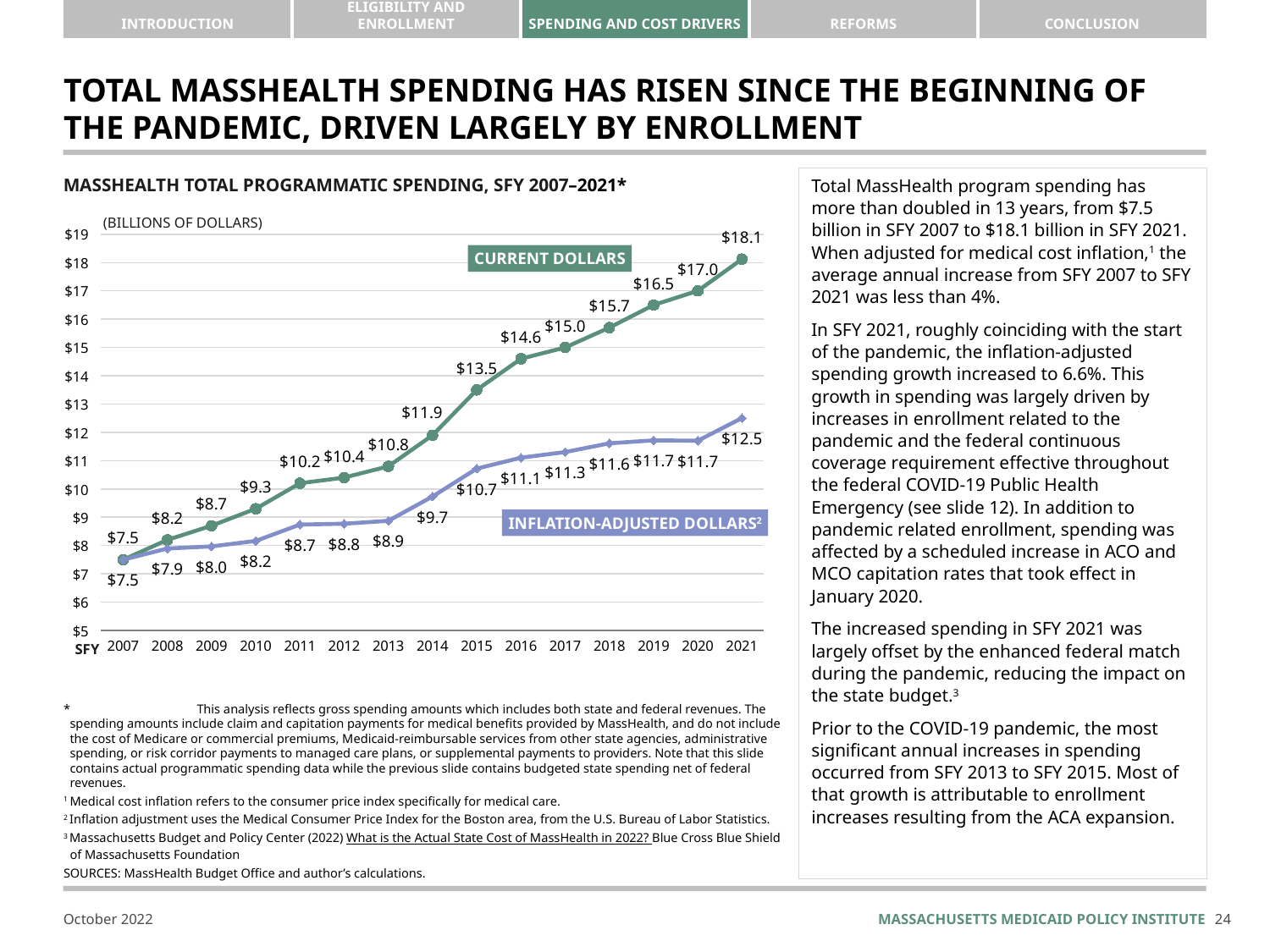
In which year was current-dollar spending highest? 2021 What is the difference between current-dollar and inflation-adjusted spending in SFY 2021? $5.6 By how much did current-dollar spending increase from SFY 2007 to SFY 2021? $10.6 What was the inflation-adjusted spending value for SFY 2015? $10.7 What was the current-dollar spending value for SFY 2014? $11.9 What was MassHealth total programmatic spending in current dollars in SFY 2021? $18.1 Which is larger in SFY 2018: current-dollar spending or inflation-adjusted spending? Current dollars What type of chart is shown on the slide? Line chart In which year was inflation-adjusted spending lowest? 2007 How many data series does the chart show? 2 What is the overall trend of current-dollar spending from 2007 to 2021? Rising How many years are plotted on the x axis? 15